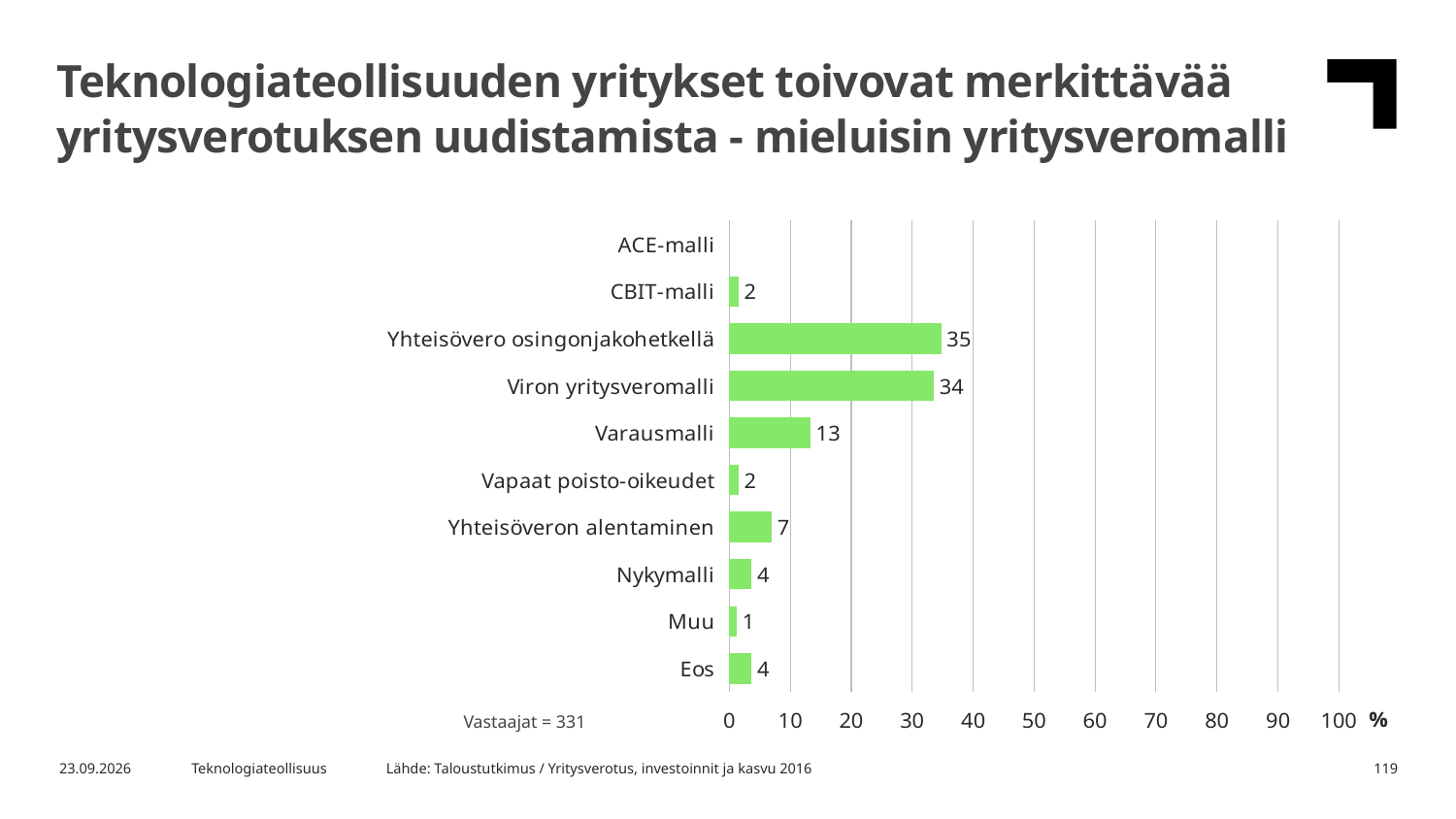
Is the value for Viron yritysveromalli greater or less than 30? greater What is the value for Yhteisöveron alentaminen? 7 What is the value for Yhteisövero osingonjakohetkellä? 35 What is the value for Viron yritysveromalli? 34 How many categories are shown on the chart? 10 What is the value for Muu? 1 What kind of chart is shown on the slide? bar chart What is the difference between the values for Varausmalli and Yhteisöveron alentaminen? 6 Which is larger, the value for Nykymalli or the value for Yhteisöveron alentaminen? Yhteisöveron alentaminen What is the difference between the values for Yhteisövero osingonjakohetkellä and Viron yritysveromalli? 1 Which category has the highest value? Yhteisövero osingonjakohetkellä What is the value for Varausmalli? 13